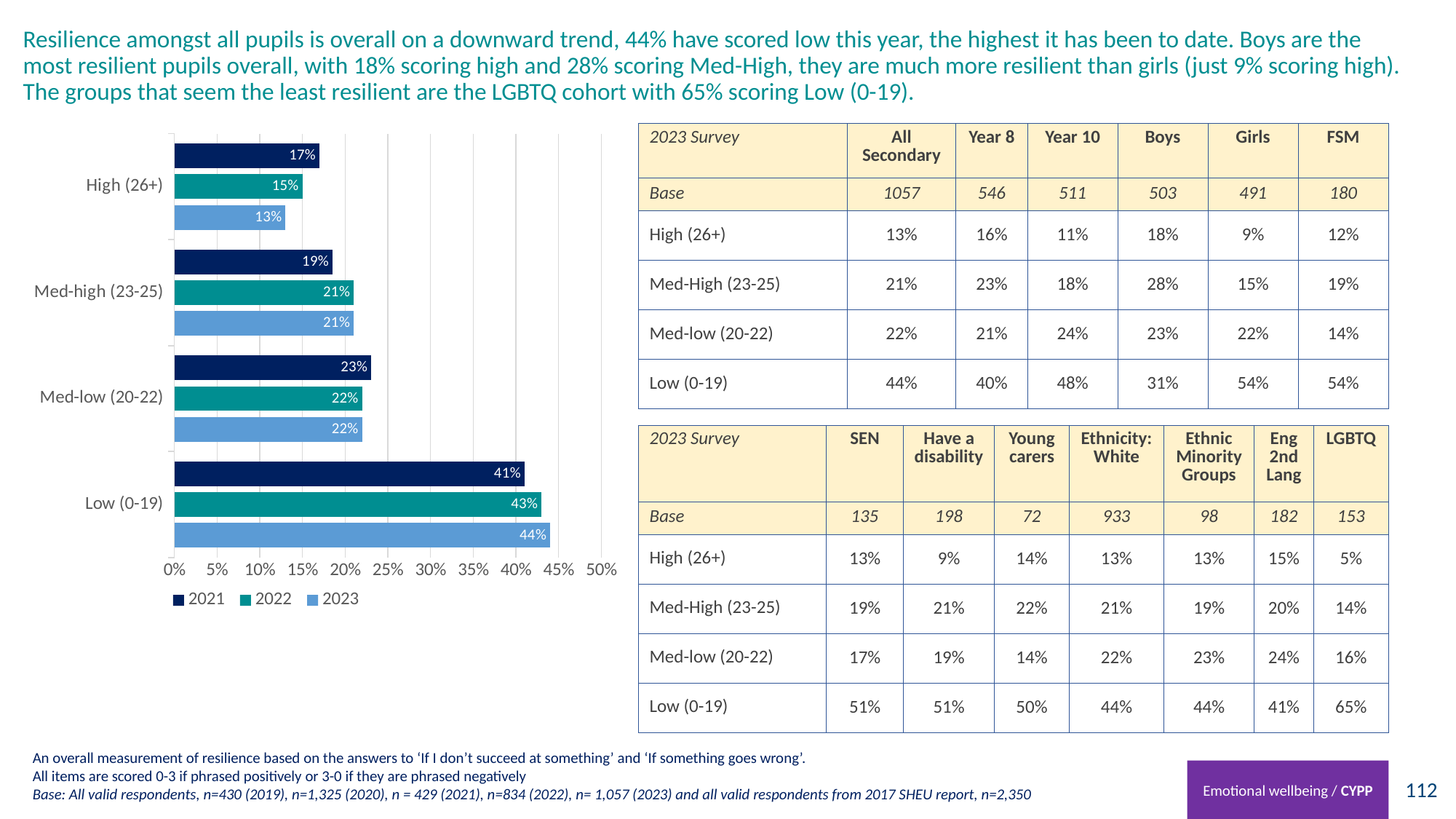
How many categories are shown on the chart? 4 What is the difference between the 2021 and 2023 values for High (26+)? 4% Which category has the lowest 2023 value? High (26+) How many series does the chart legend list? 3 What is the 2021 value for High (26+)? 17% What kind of chart is shown on the slide? bar chart Which series is shown in the darkest blue colour in the legend? 2021 Which category has the highest 2023 value? Low (0-19) What is the 2023 value for Low (0-19)? 44% What is the 2022 value for Med-high (23-25)? 21% Which is larger for Low (0-19): the 2021 value or the 2023 value? 2023 Does the 2023 value for High (26+) rise or fall compared with 2021? fall